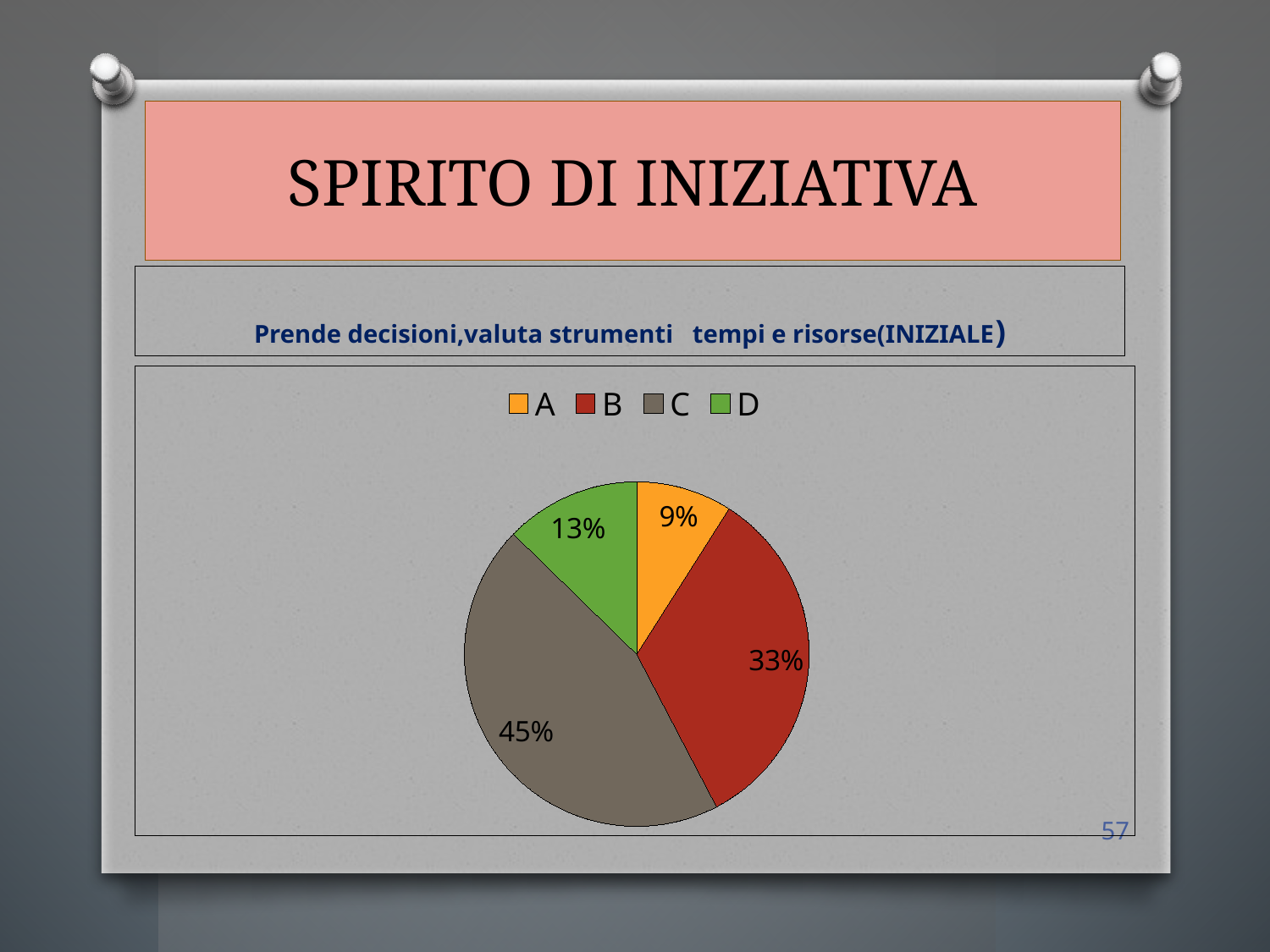
What percentage of the pie does category D represent? 13% How many entries does the legend list? 4 What type of chart is shown on the slide? pie chart Which category has a larger share, B or D? B What colour is the slice for category D? green What is the difference in percentage points between category C and category B? 12 How many slices does the pie chart have? 4 What percentage of the pie does category C represent? 45% Which category has the largest share of the pie? C Which category has the smallest share of the pie? A What percentage of the pie does category A represent? 9% What percentage of the pie does category B represent? 33%